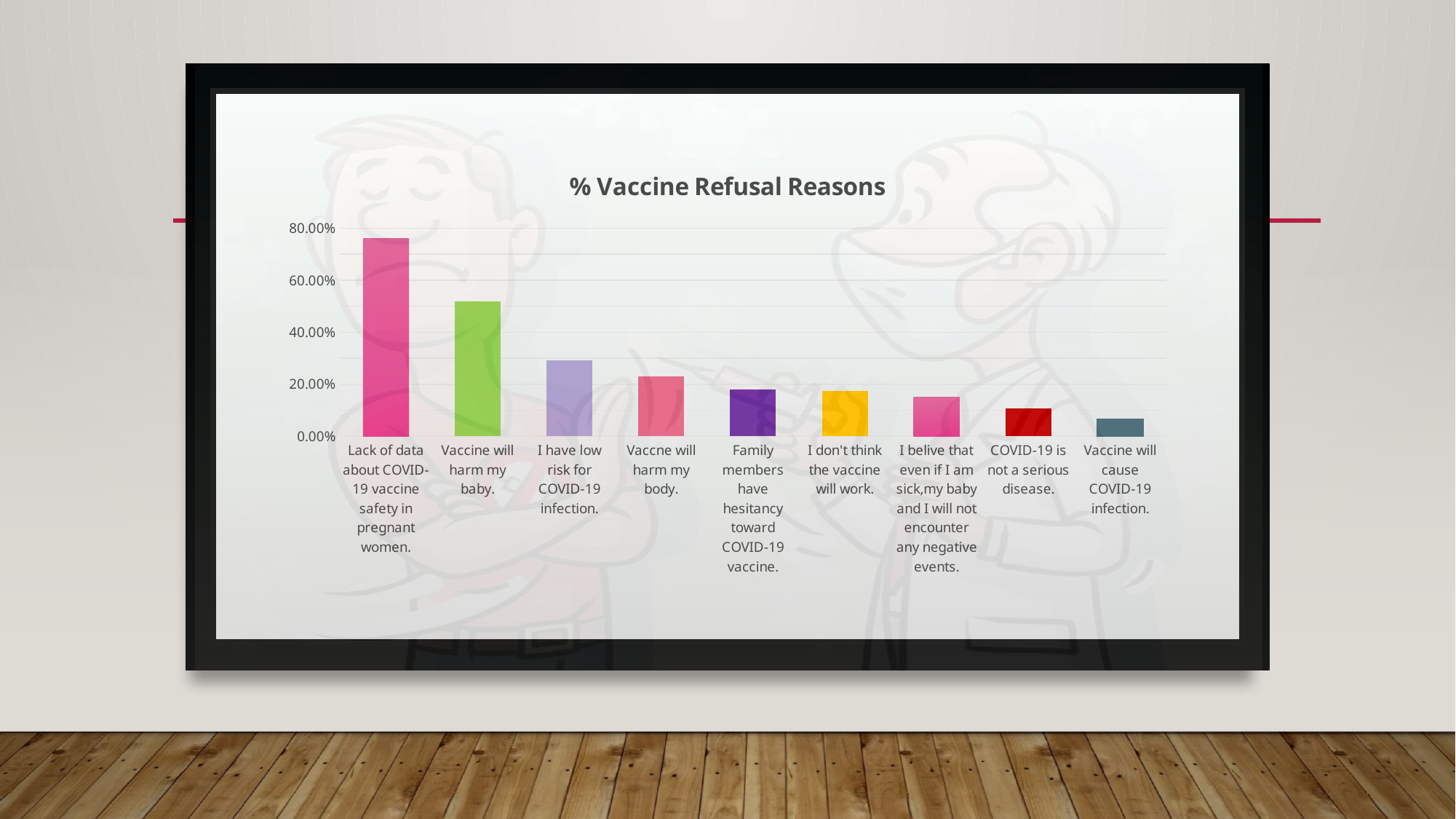
Is the value for "I have low risk for COVID-19 infection." greater or less than 40.00%? less Is the value for "Lack of data about COVID-19 vaccine safety in pregnant women." greater or less than 60.00%? greater Which is larger: the value for "Vaccine will harm my baby." or the value for "Vaccne will harm my body."? Vaccine will harm my baby. What kind of chart is shown on the slide? bar chart What colour is the bar for "I don't think the vaccine will work."? yellow What is the title of the chart? % Vaccine Refusal Reasons Is the value for "COVID-19 is not a serious disease." greater or less than 20.00%? less Which refusal reason has the lowest percentage? Vaccine will cause COVID-19 infection. Which refusal reason has the highest percentage? Lack of data about COVID-19 vaccine safety in pregnant women. Do the bar values rise or fall moving from left to right along the x axis? fall How many refusal reasons (categories) are plotted in the chart? 9